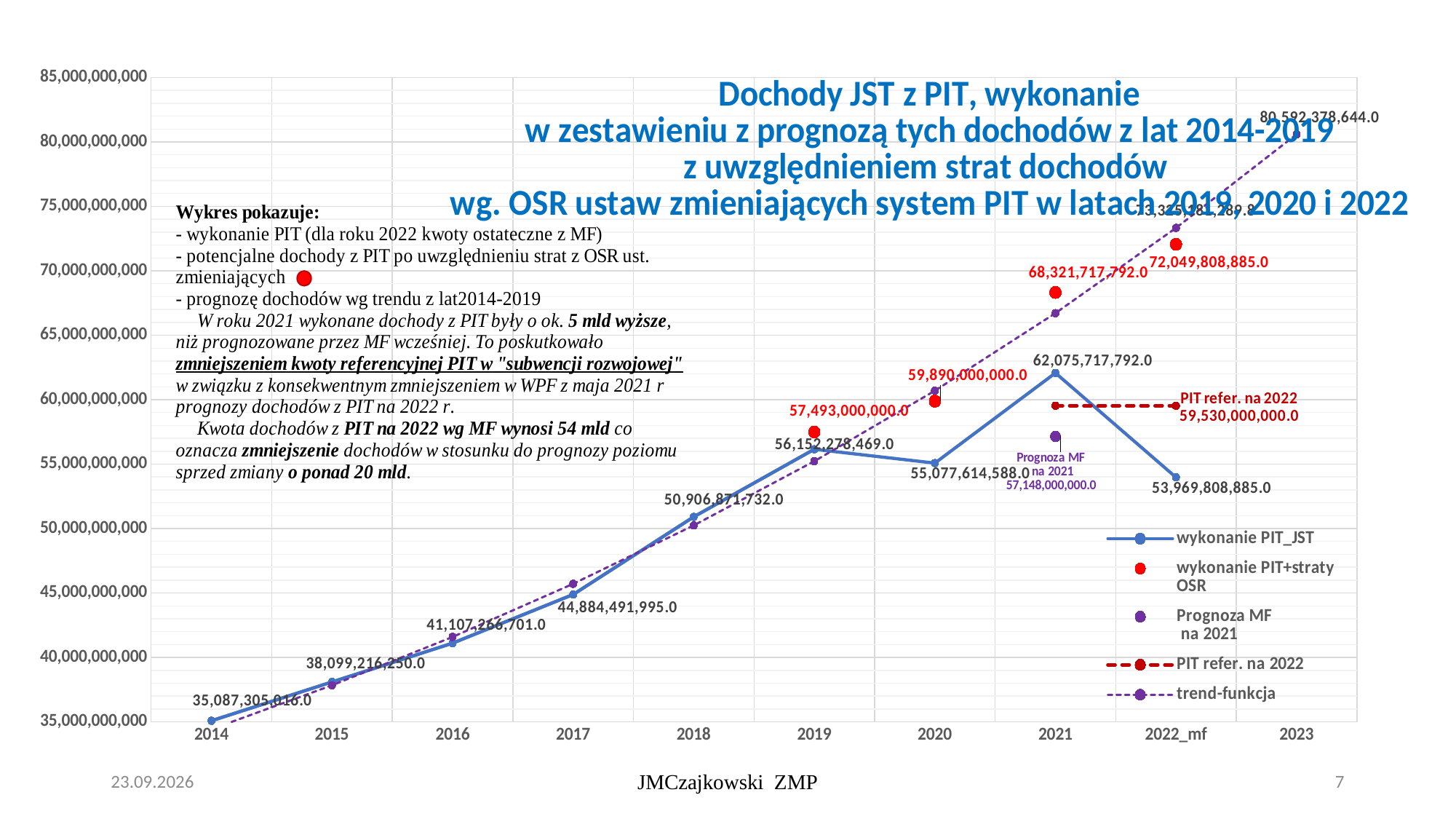
What is the value of wykonanie PIT+straty OSR for 2021? 68,321,717,792.0 What kind of chart is shown on the slide? line chart What is the difference between wykonanie PIT_JST in 2021 and in 2020? 6,998,103,204.0 How many series does the chart legend list? 5 In which year is wykonanie PIT_JST highest? 2021 Does wykonanie PIT_JST rise or fall from 2014 to 2019? rise In which year is wykonanie PIT_JST lowest? 2014 Which year has the larger wykonanie PIT_JST value, 2019 or 2020? 2019 What is the value of PIT refer. na 2022? 59,530,000,000.0 What is the value of wykonanie PIT_JST for 2022_mf? 53,969,808,885.0 How many years are shown on the x axis of the chart? 10 What is the value of wykonanie PIT_JST for 2021? 62,075,717,792.0